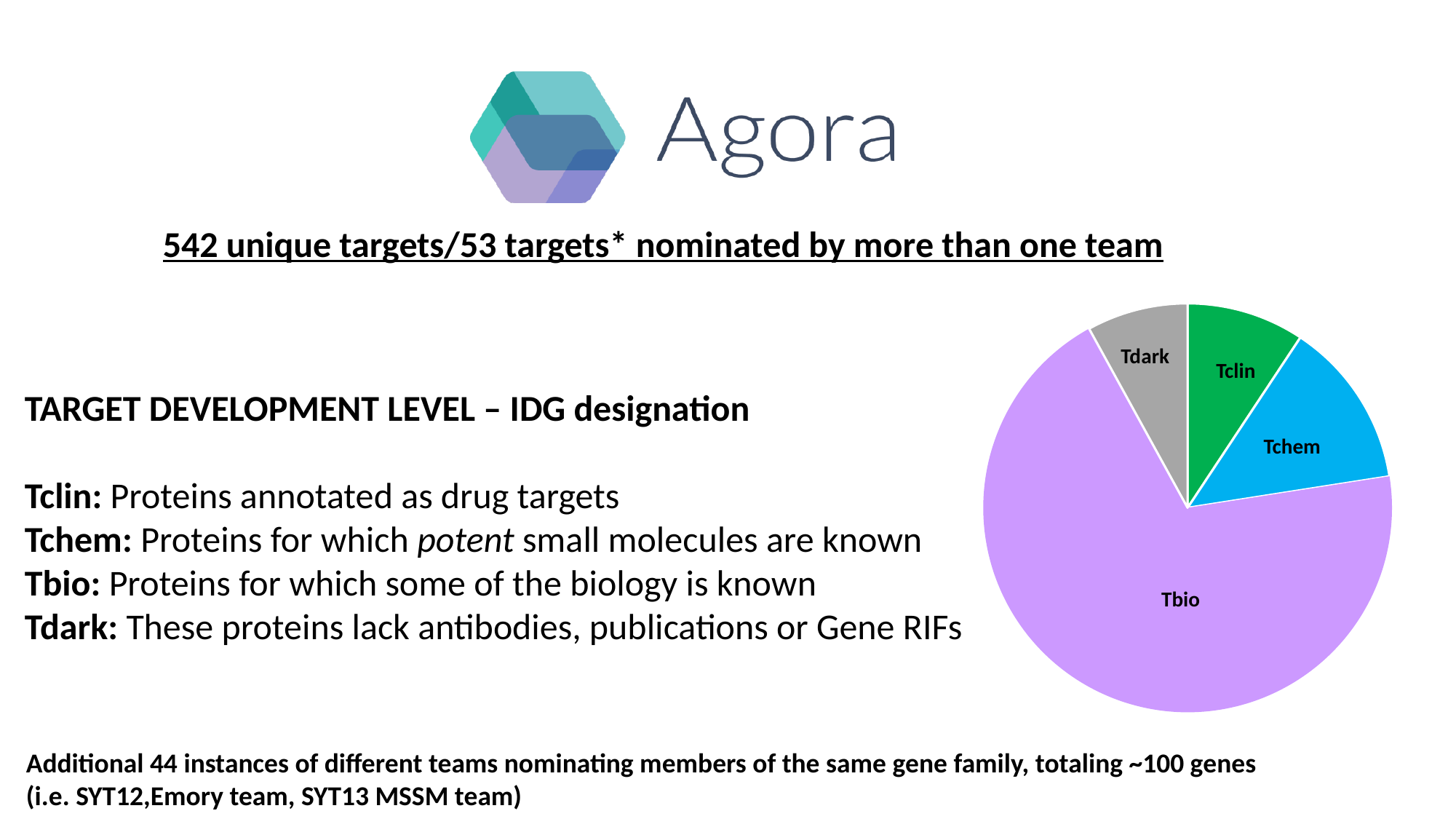
How many slices does the pie chart have? 4 What colour is the Tbio slice in the pie chart? purple Which category in the pie chart is shown in green? Tclin Which slice is larger in the pie chart, Tbio or Tdark? Tbio Which slice is larger in the pie chart, Tchem or Tdark? Tchem Which category has the largest slice in the pie chart? Tbio What kind of chart is shown on the slide? pie chart Which slice is larger in the pie chart, Tbio or Tchem? Tbio